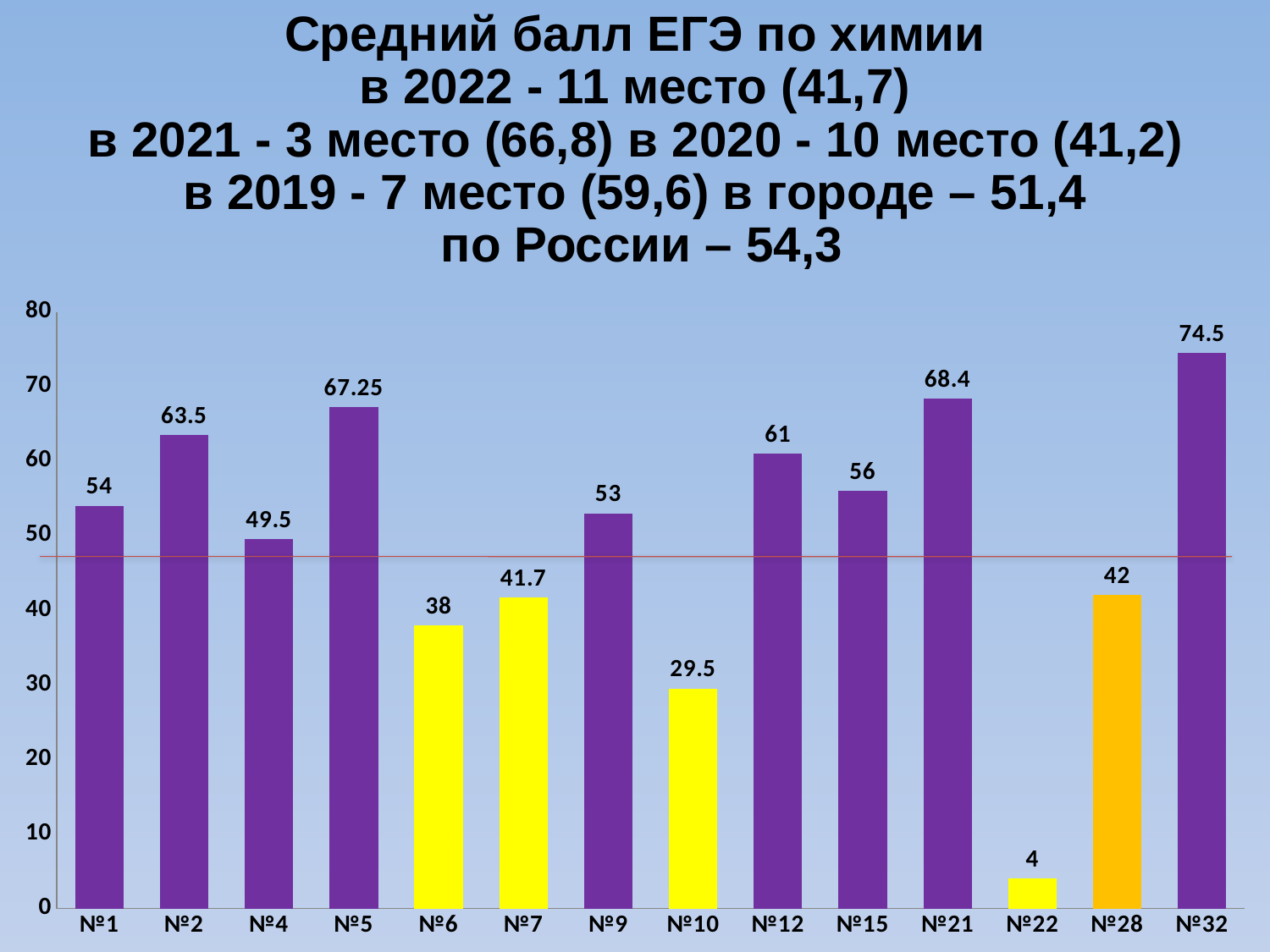
What is the value for №5? 67.25 Which category has the highest value? №32 What is the difference between the values for №32 and №21? 6.1 What kind of chart is shown on the slide? bar chart Which is larger, the value for №12 or the value for №15? №12 What is the value for №10? 29.5 What colour is the bar for №28? orange What is the difference between the values for №2 and №1? 9.5 What is the value for №28? 42 How many categories are shown on the x axis? 14 Is the value for №7 greater or less than 50? less Which category has the lowest value? №22